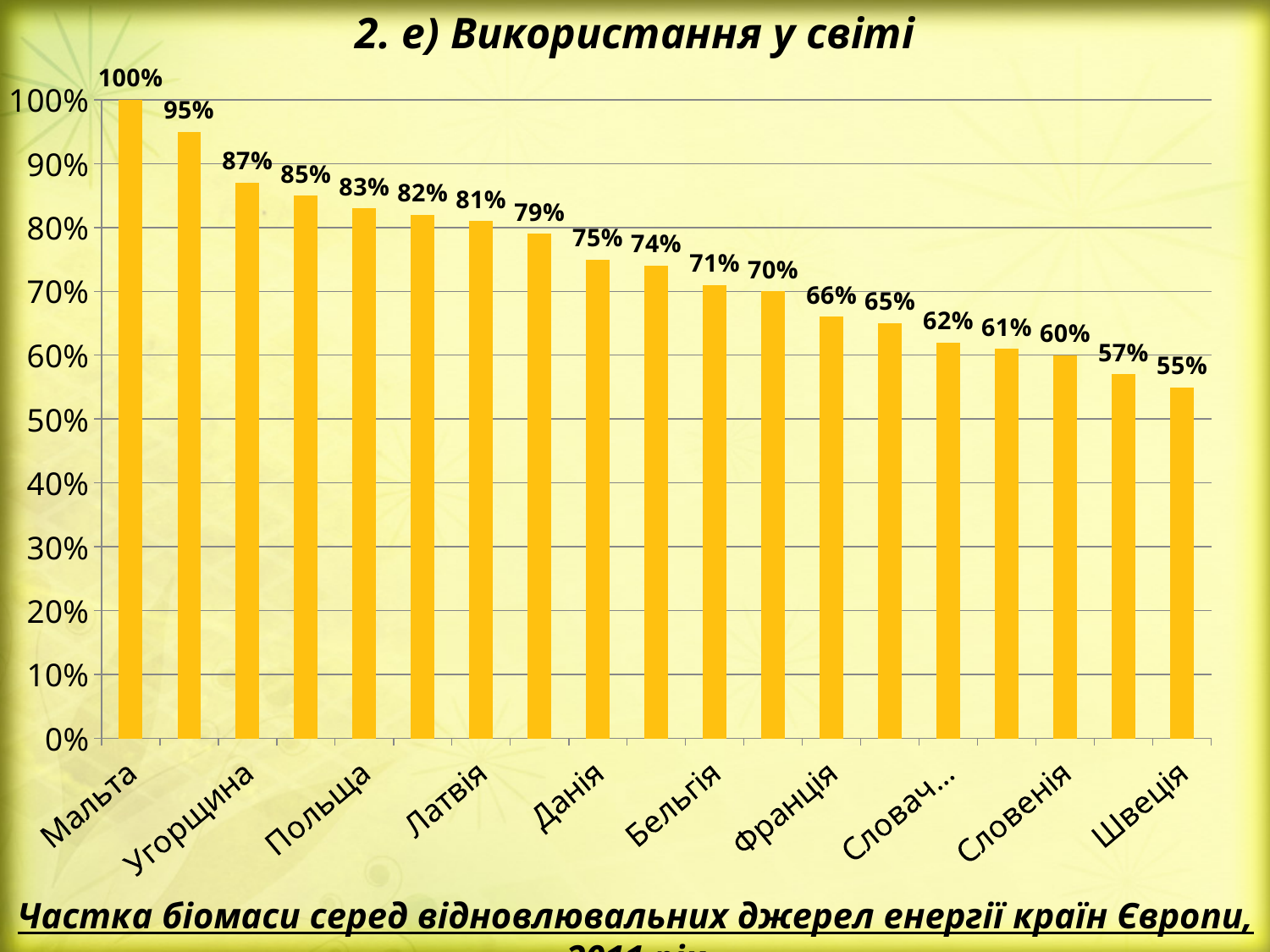
How many bars are plotted in the chart? 19 Which country has the highest value? Мальта Which country has the lowest value? Швеція What is the value for Швеція? 55% What kind of chart is shown on the slide? bar chart Which has a larger value, Польща or Латвія? Польща What is the difference between the values for Мальта and Швеція? 45 percentage points What is the value for Франція? 66% What is the value for Угорщина? 87% What is the value for Мальта? 100% What is the value for Данія? 75% Do the values rise or fall from left to right along the x axis? fall